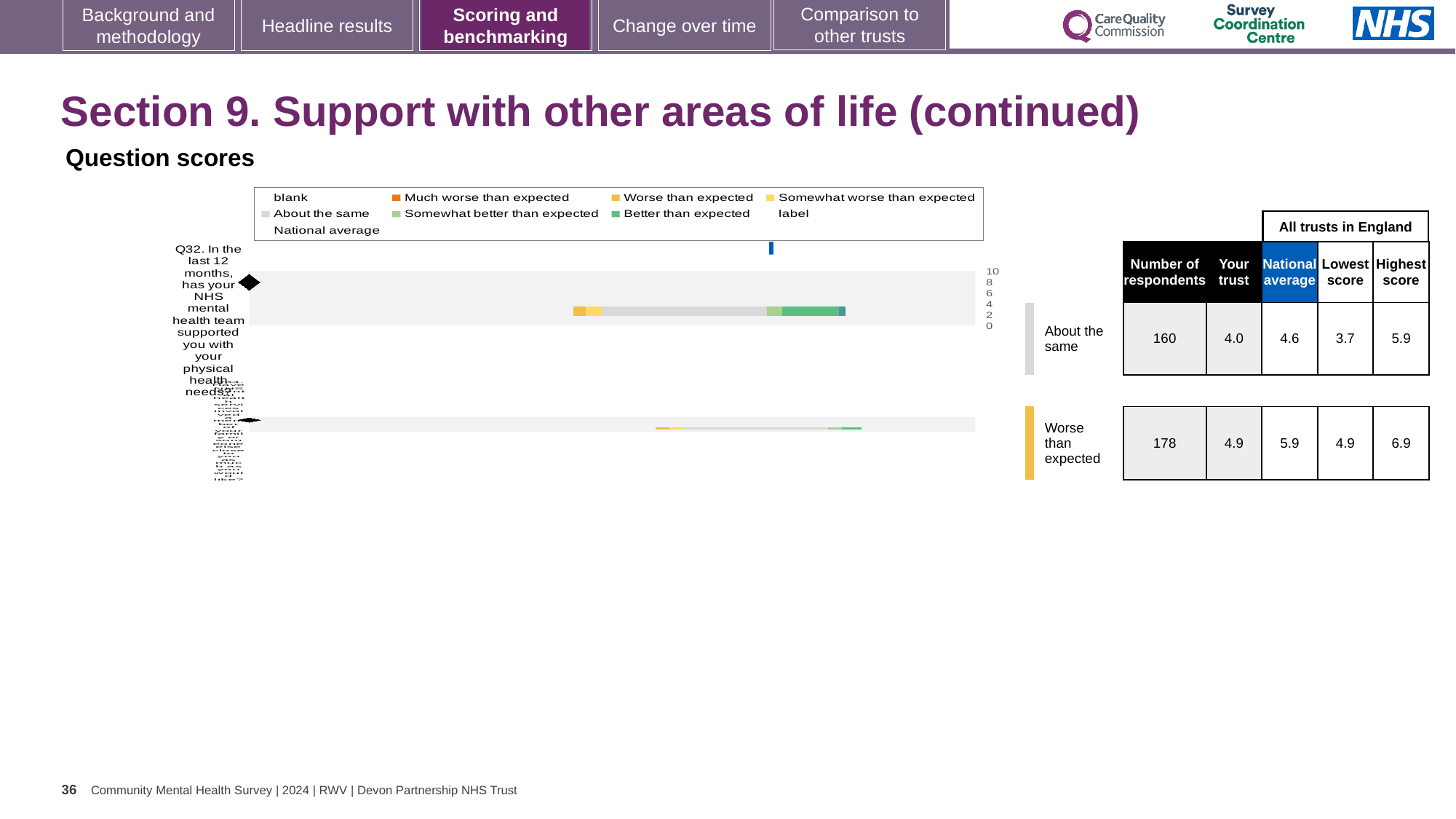
How many respondents answered Q32 (support with physical health needs)? 160 What benchmark category is Q32 (support with physical health needs) rated as? About the same What is the difference between the national average (4.6) and the 'Your trust' score (4.0) for Q32? 0.6 What is the 'Your trust' score for Q32 (support with physical health needs)? 4.0 What colour is the 'Better than expected' legend entry? green What is the highest score across all trusts in England for the second question, rated 'Worse than expected'? 6.9 What is the national average score for Q32 (support with physical health needs)? 4.6 Which is larger for Q32: the 'Your trust' score or the national average? National average What is the difference between the highest score (5.9) and the lowest score (3.7) for Q32? 2.2 What is the 'Your trust' score for the second question, rated 'Worse than expected'? 4.9 What is the highest value shown on the chart's numeric axis? 10 What kind of chart is shown on the slide? bar chart